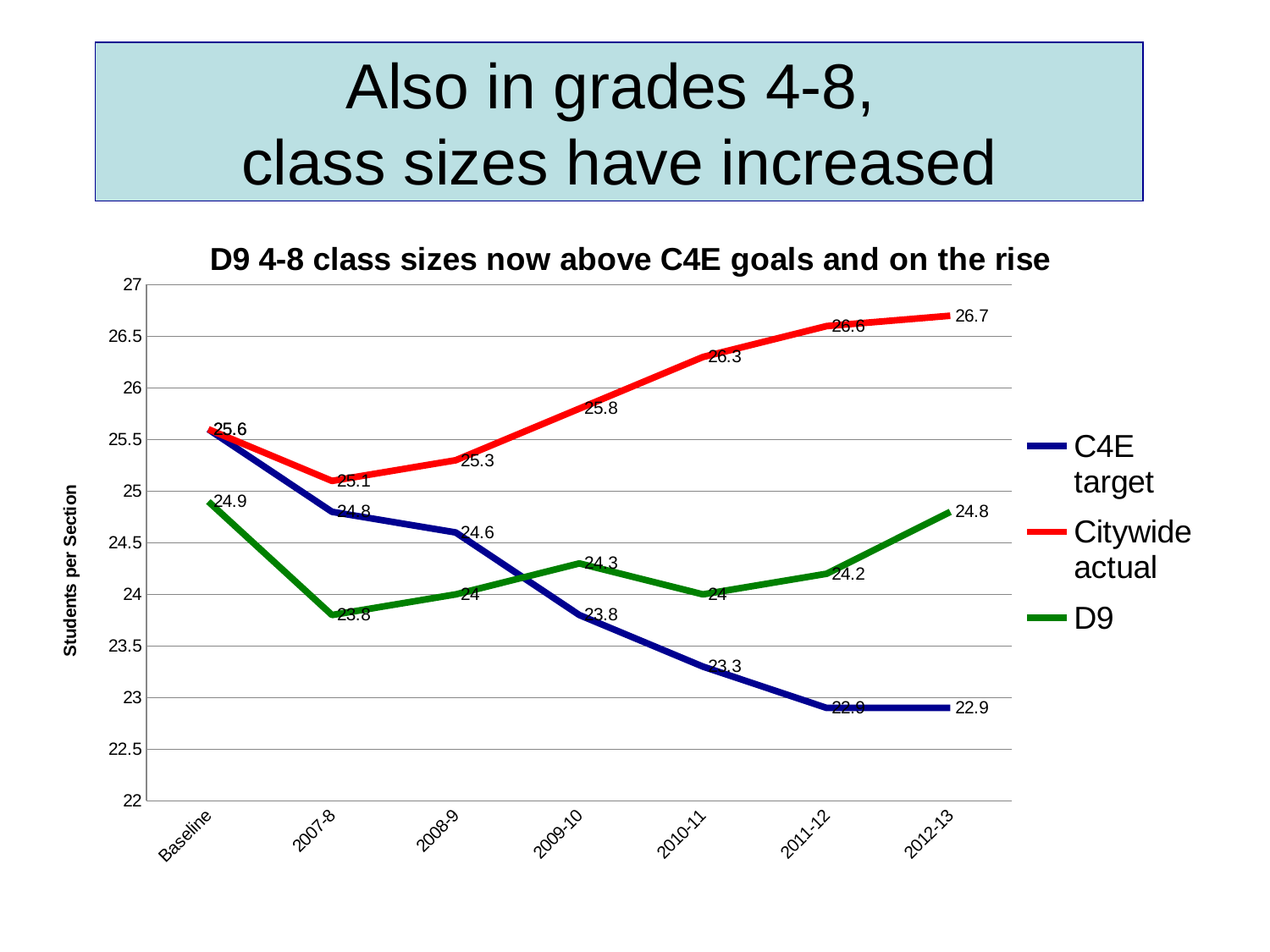
What is the D9 value for 2009-10? 24.3 How many time points are shown on the x axis? 7 In which year is the Citywide actual value highest? 2012-13 What is the Citywide actual value for 2012-13? 26.7 What is the title of the chart? D9 4-8 class sizes now above C4E goals and on the rise How many series does the legend list? 3 In which year is the D9 value lowest? 2007-8 In 2011-12, which is larger: the D9 value or the C4E target value? D9 What kind of chart is shown on the slide? Line chart What is the difference between the Citywide actual and D9 values in 2012-13? 1.9 Does the C4E target series rise or fall from Baseline to 2012-13? Fall What is the C4E target value for 2010-11? 23.3